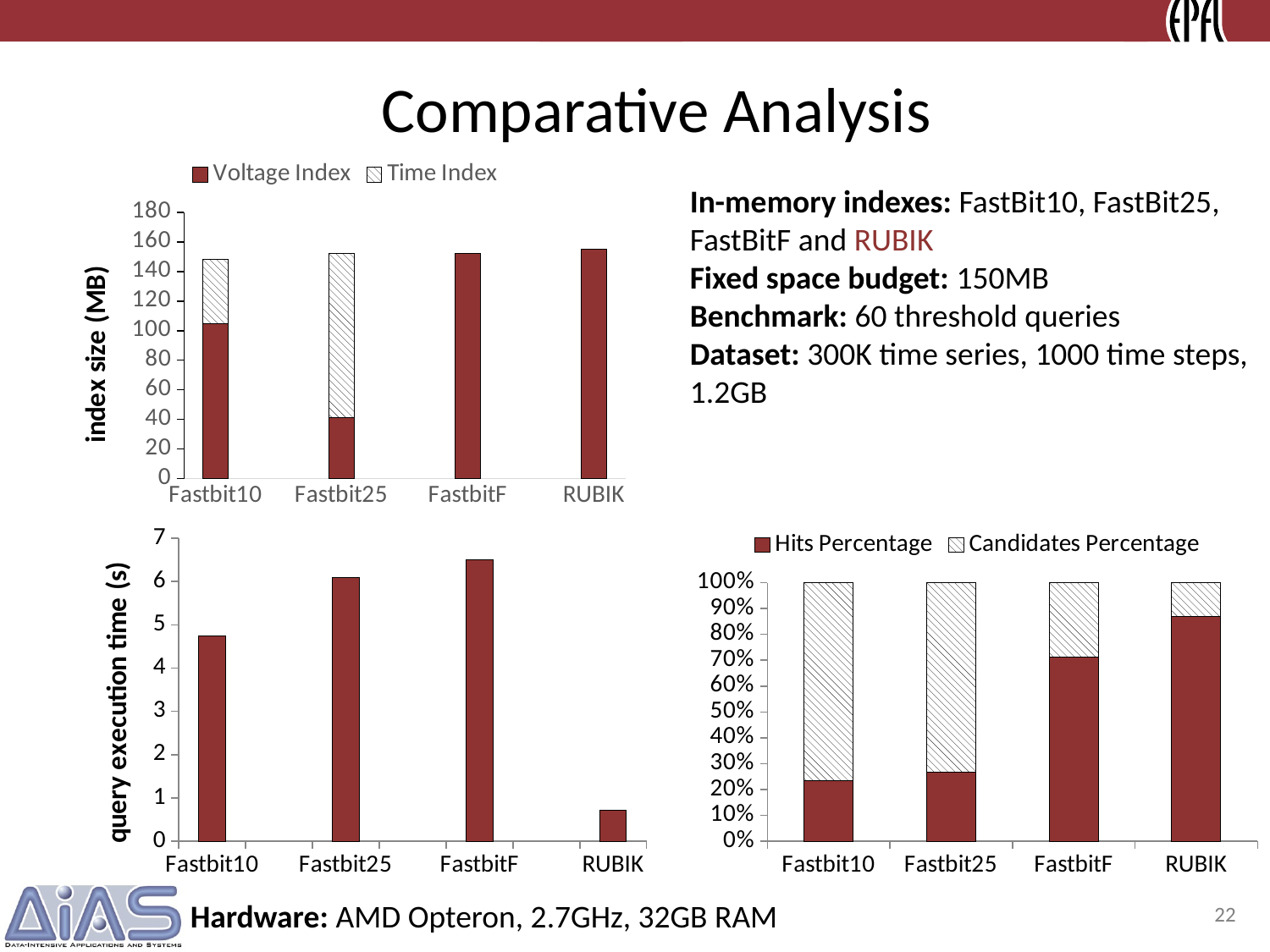
In the query execution time (s) chart at the bottom left, how many categories are shown on the x axis? 4 In the index size (MB) chart at the top left, which categories have no Time Index segment? FastbitF and RUBIK In the Hits Percentage / Candidates Percentage chart at the bottom right, is the Hits Percentage for RUBIK greater or less than 80%? greater In the Hits Percentage / Candidates Percentage chart at the bottom right, which category has the highest Hits Percentage? RUBIK In the query execution time (s) chart at the bottom left, which category has the lowest value? RUBIK In the index size (MB) chart at the top left, is the Voltage Index value for Fastbit25 greater or less than 60? less In the index size (MB) chart at the top left, how many series does the legend list? 2 In the query execution time (s) chart at the bottom left, is the value for RUBIK greater or less than 1? less In the index size (MB) chart at the top left, which category has the lowest Voltage Index value? Fastbit25 In the query execution time (s) chart at the bottom left, which is larger, the value for Fastbit10 or Fastbit25? Fastbit25 In the query execution time (s) chart at the bottom left, which category has the highest value? FastbitF